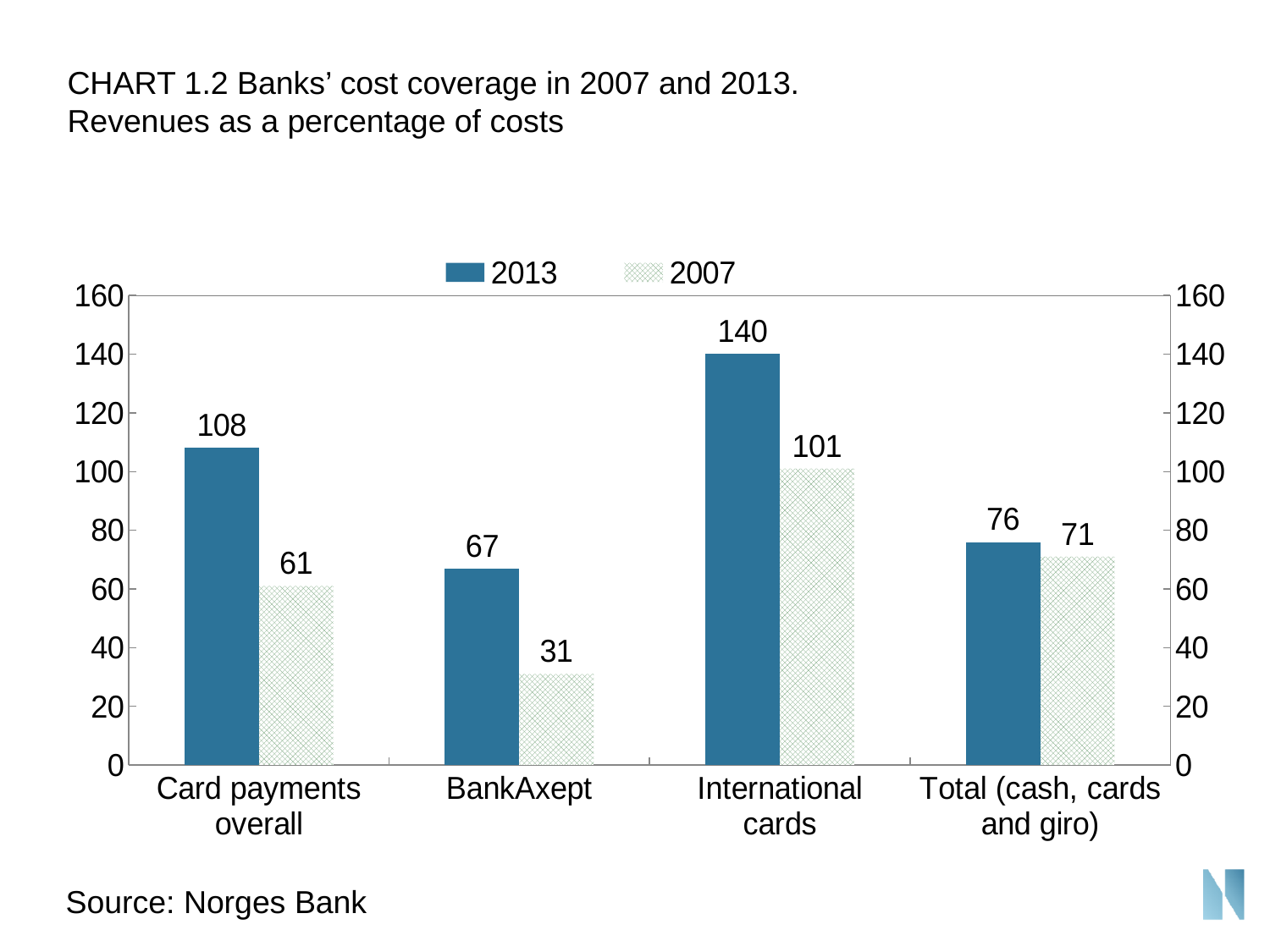
Which is larger: the 2007 value for International cards or the 2013 value for Card payments overall? 2013 value for Card payments overall How many series does the legend list? 2 What is the 2007 value for Total (cash, cards and giro)? 71 Which category has the lowest 2007 value? BankAxept How many categories are shown on the x axis? 4 What is the 2007 value for BankAxept? 31 What is the difference between the 2013 and 2007 values for Card payments overall? 47 What is the 2013 value for International cards? 140 Which category has the highest 2013 value? International cards What is the 2013 value for Card payments overall? 108 What is the source cited for the chart? Norges Bank What kind of chart is shown? Bar chart